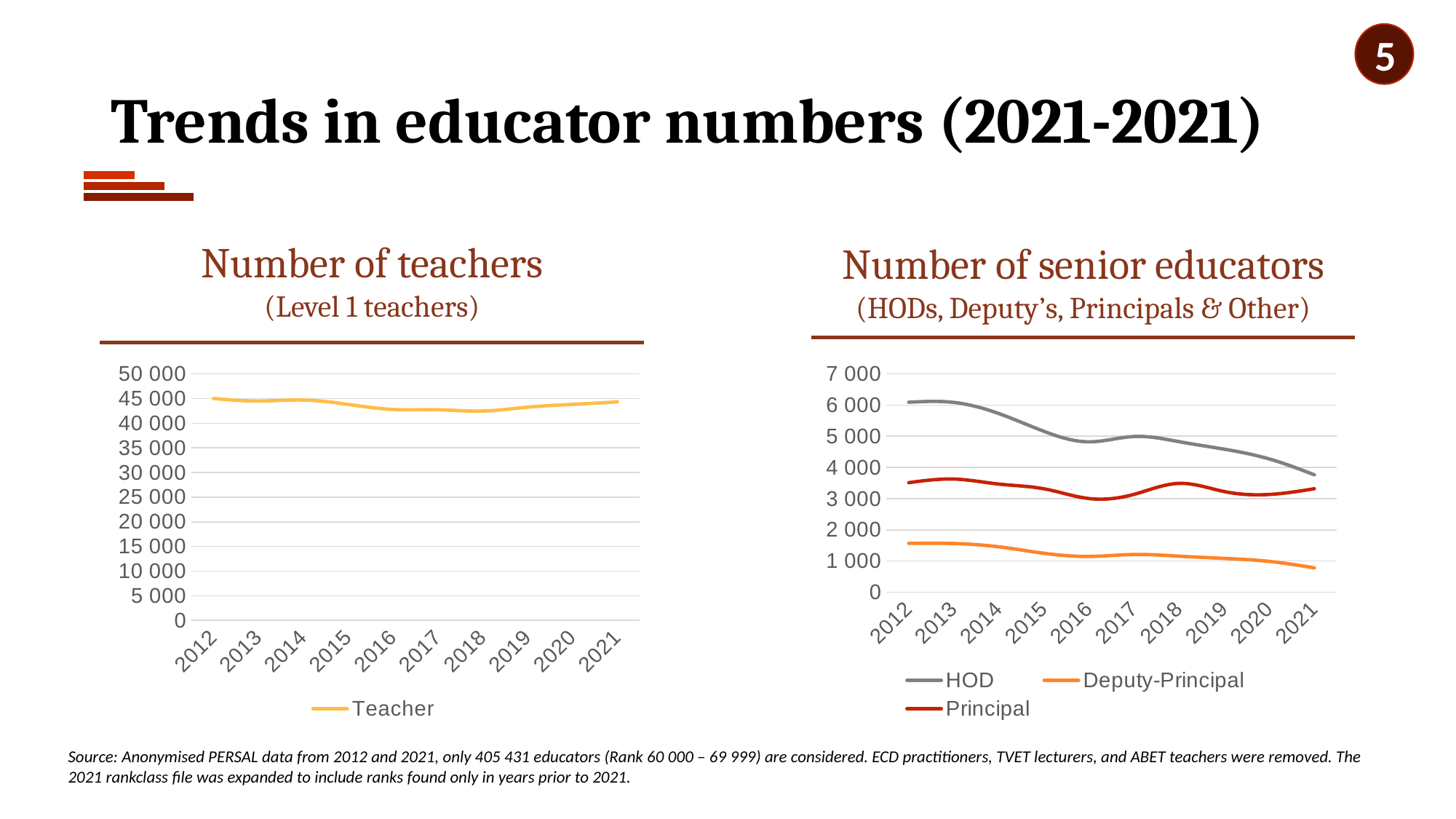
In the "Number of senior educators" chart, which series has the lowest value in 2012? Deputy-Principal In the "Number of teachers" chart, is the value for Teacher in 2012 greater or less than 40 000? greater In the "Number of senior educators" chart, which series has the highest value in 2021? HOD In the "Number of senior educators" chart, is the value for Deputy-Principal in 2021 greater or less than 1 000? less In the "Number of teachers" chart, is the value for Teacher in 2018 greater or less than 45 000? less How many series does the legend of the "Number of senior educators" chart list? 3 How many years are shown on the x axis of the "Number of senior educators" chart? 10 In the "Number of senior educators" chart, does the HOD series rise or fall from 2012 to 2021? fall What kind of chart is the "Number of teachers" chart on the left? line chart